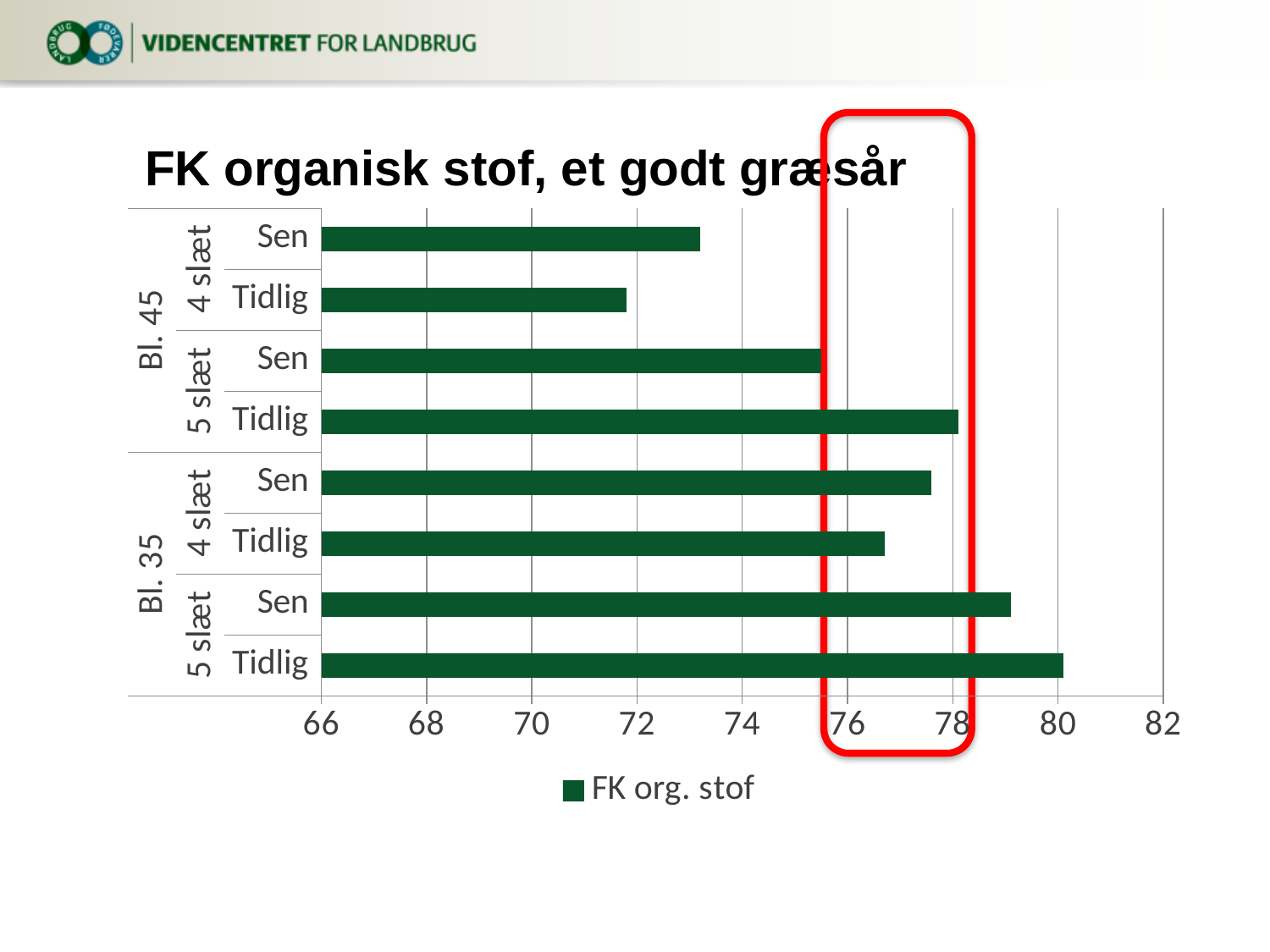
How many series does the legend list? 1 Which bar has the highest value? Bl. 35, 5 slæt, Tidlig What kind of chart is shown on the slide? Bar chart Which is larger: the value for Bl. 35, 4 slæt, Sen or the value for Bl. 45, 4 slæt, Sen? Bl. 35, 4 slæt, Sen Is the value for Bl. 45, 5 slæt, Sen greater or less than 76? less Is the value for Bl. 45, 4 slæt, Tidlig greater or less than 72? less What is the name of the series shown in the legend? FK org. stof Which bar has the lowest value? Bl. 45, 4 slæt, Tidlig What is the title of the chart? FK organisk stof, et godt græsår Which is larger: the value for Bl. 45, 5 slæt, Tidlig or the value for Bl. 45, 5 slæt, Sen? Bl. 45, 5 slæt, Tidlig How many bars are plotted in the chart? 8